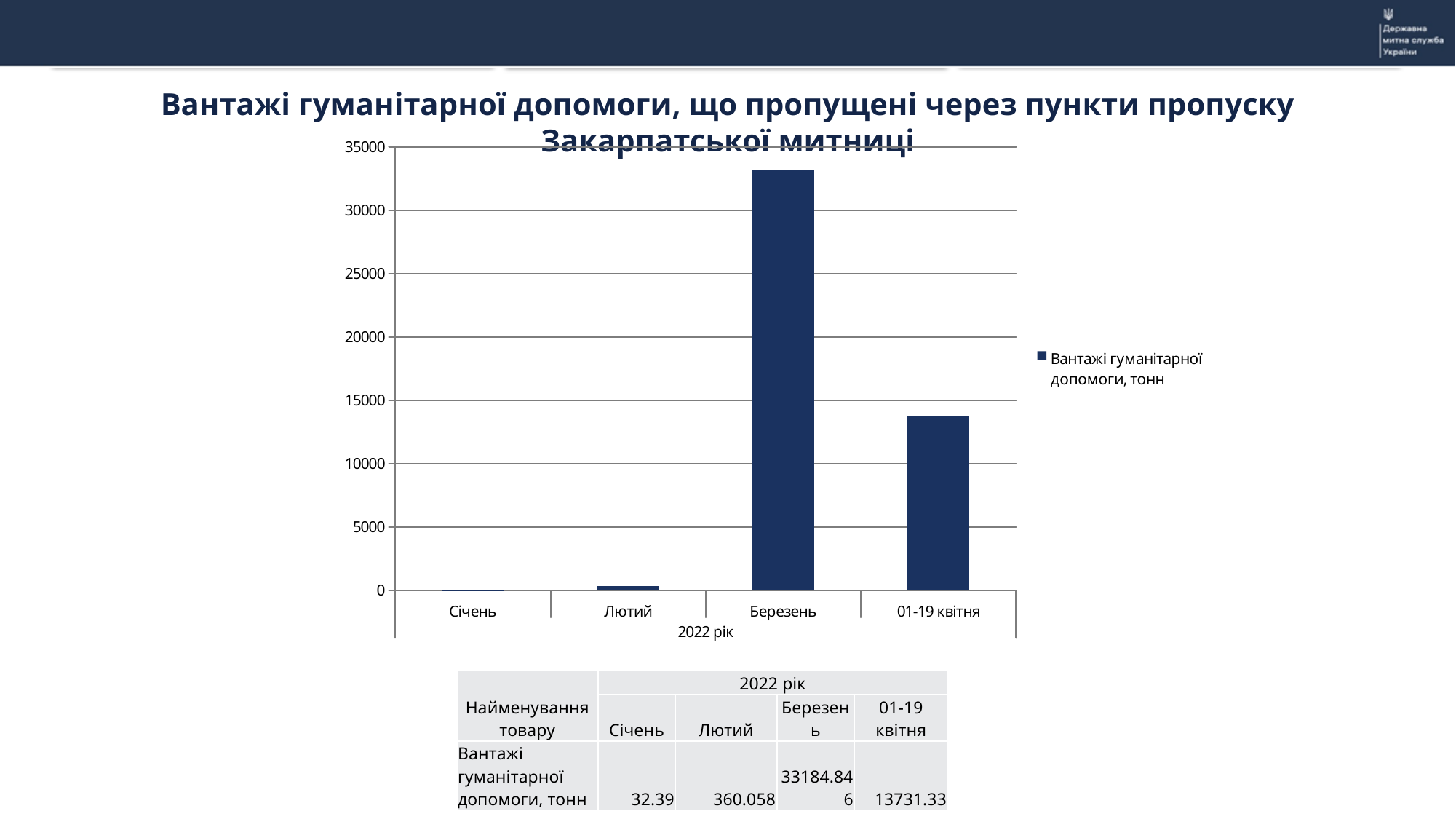
How many series does the legend list? 1 What type of chart is shown on the slide? bar chart What is the value for Березень (tonnes)? 33184.846 What is the value for 01-19 квітня (tonnes)? 13731.33 Is the value for 01-19 квітня greater or less than 15000? less Which is larger, the value for Березень or the value for 01-19 квітня? Березень Which category has the lowest value? Січень How many categories are shown on the x axis of the chart? 4 What is the value for Лютий (tonnes)? 360.058 What is the value for Січень (tonnes)? 32.39 What is the difference between the values for Березень and 01-19 квітня? 19453.516 Which category has the highest value? Березень